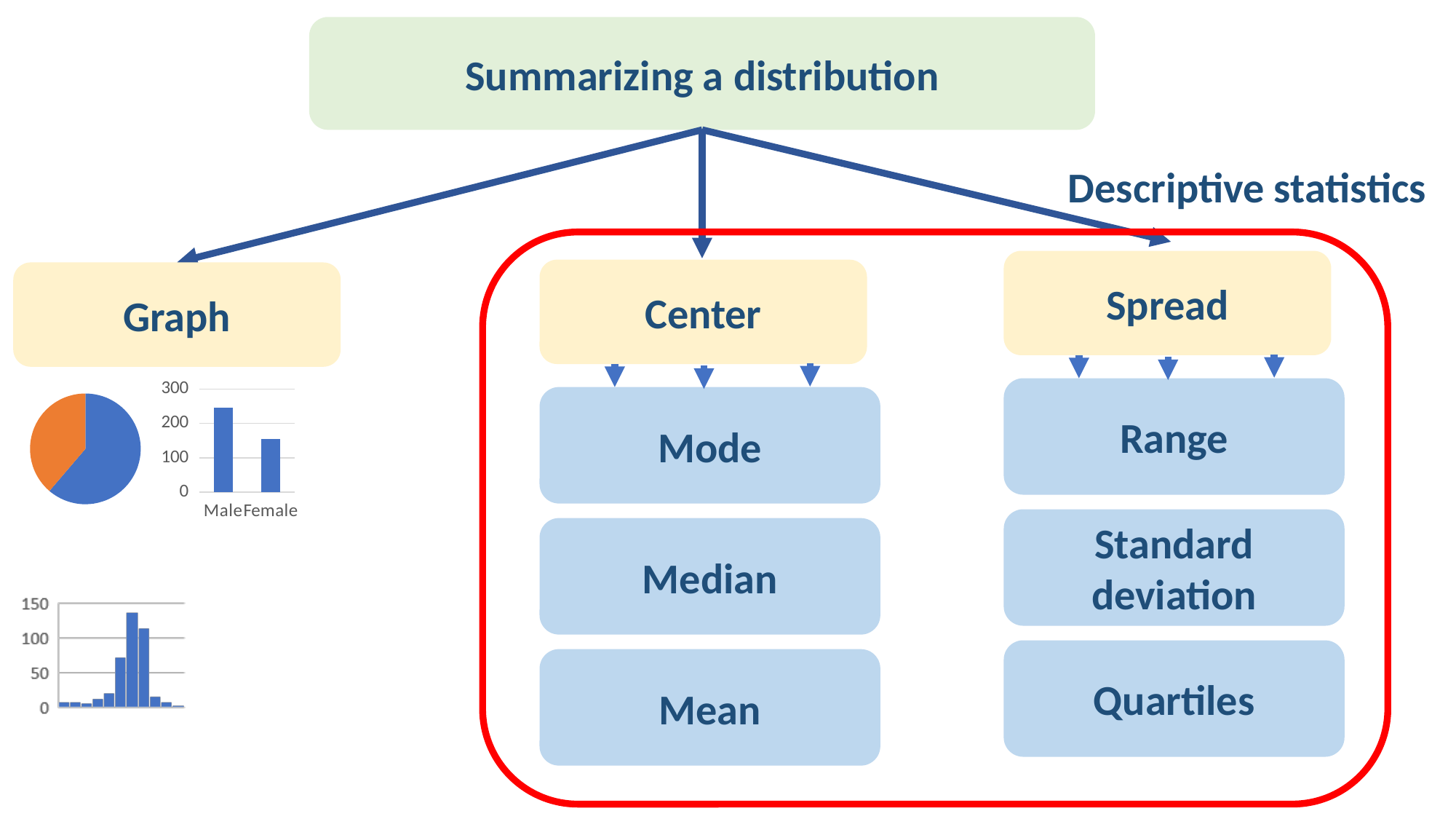
In the bar chart with Male and Female categories, is the value for Female greater or less than 100? greater How many slices does the pie chart have? 2 In the bar chart with Male and Female categories, is the value for Female greater or less than 200? less In the bar chart with Male and Female categories, is the value for Male greater or less than 200? greater In the bar chart with Male and Female categories, which category has the higher value? Male What is the highest tick value on the vertical axis of the bar chart at the bottom left of the slide? 150 What kind of chart is the chart with the Male and Female categories? bar chart How many categories are shown in the bar chart with Male and Female categories? 2 In the pie chart, which slice is larger, the blue one or the orange one? blue In the bar chart with Male and Female categories, which category has the lower value? Female What kind of chart is the chart at the top left of the slide, below the Graph box? pie chart